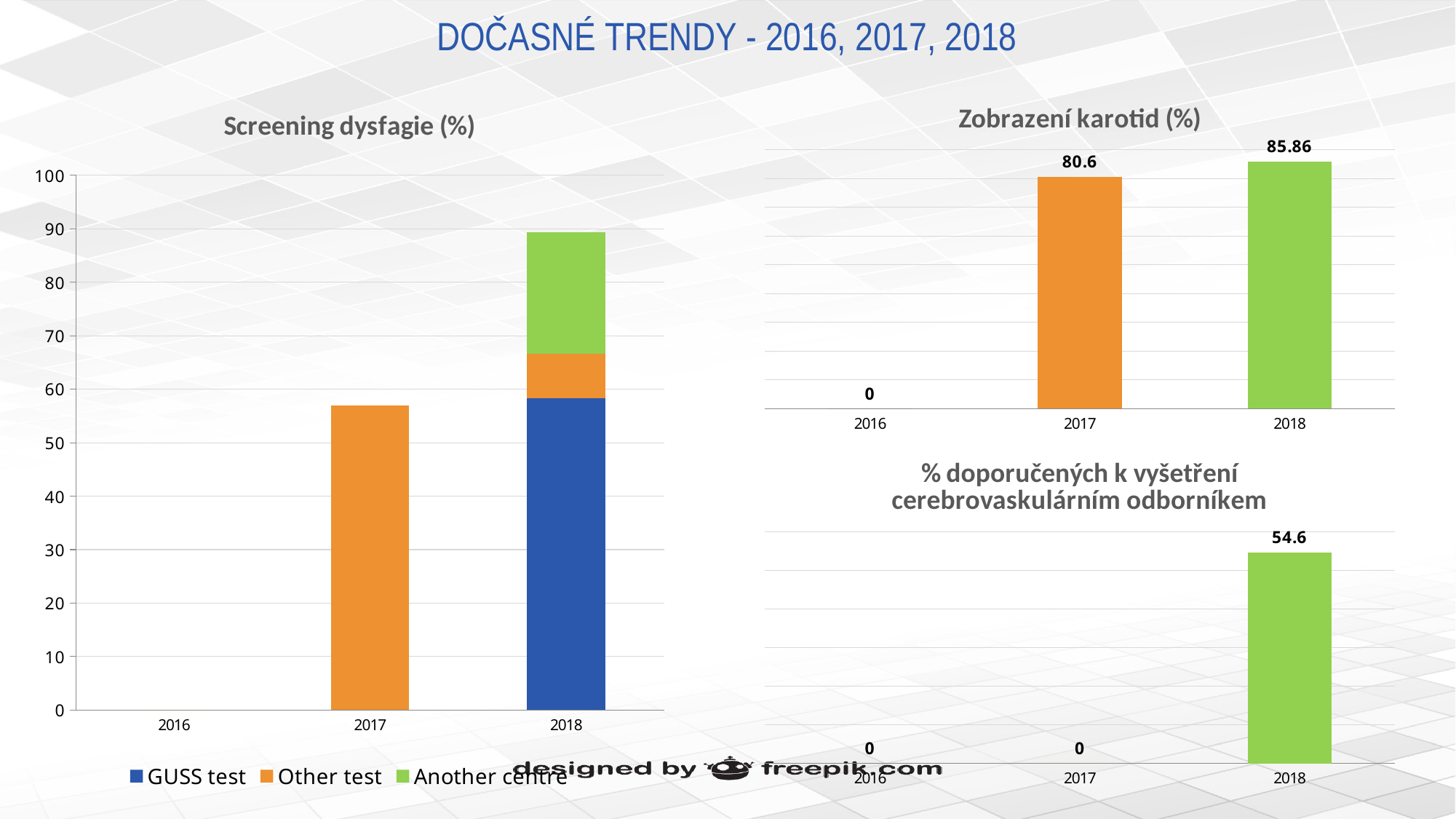
In the '% doporučených k vyšetření cerebrovaskulárním odborníkem' chart, what is the value for 2018? 54.6 What kind of chart is 'Screening dysfagie (%)'? Stacked bar chart In the 'Zobrazení karotid (%)' chart, what is the difference between the 2018 and 2017 values? 5.26 In the 'Zobrazení karotid (%)' chart, what is the value for 2018? 85.86 In the 'Screening dysfagie (%)' chart, how many series does the legend list? 3 In the '% doporučených k vyšetření cerebrovaskulárním odborníkem' chart, how many years are shown on the x axis? 3 In the 'Screening dysfagie (%)' chart, is the total stacked value for 2018 greater or less than 80? greater In the 'Screening dysfagie (%)' chart, is the value for 2017 greater or less than 50? greater In the 'Zobrazení karotid (%)' chart, what is the value for 2017? 80.6 In the 'Zobrazení karotid (%)' chart, what is the value for 2016? 0 In the 'Zobrazení karotid (%)' chart, which year has the highest value? 2018 In the '% doporučených k vyšetření cerebrovaskulárním odborníkem' chart, what is the value for 2017? 0